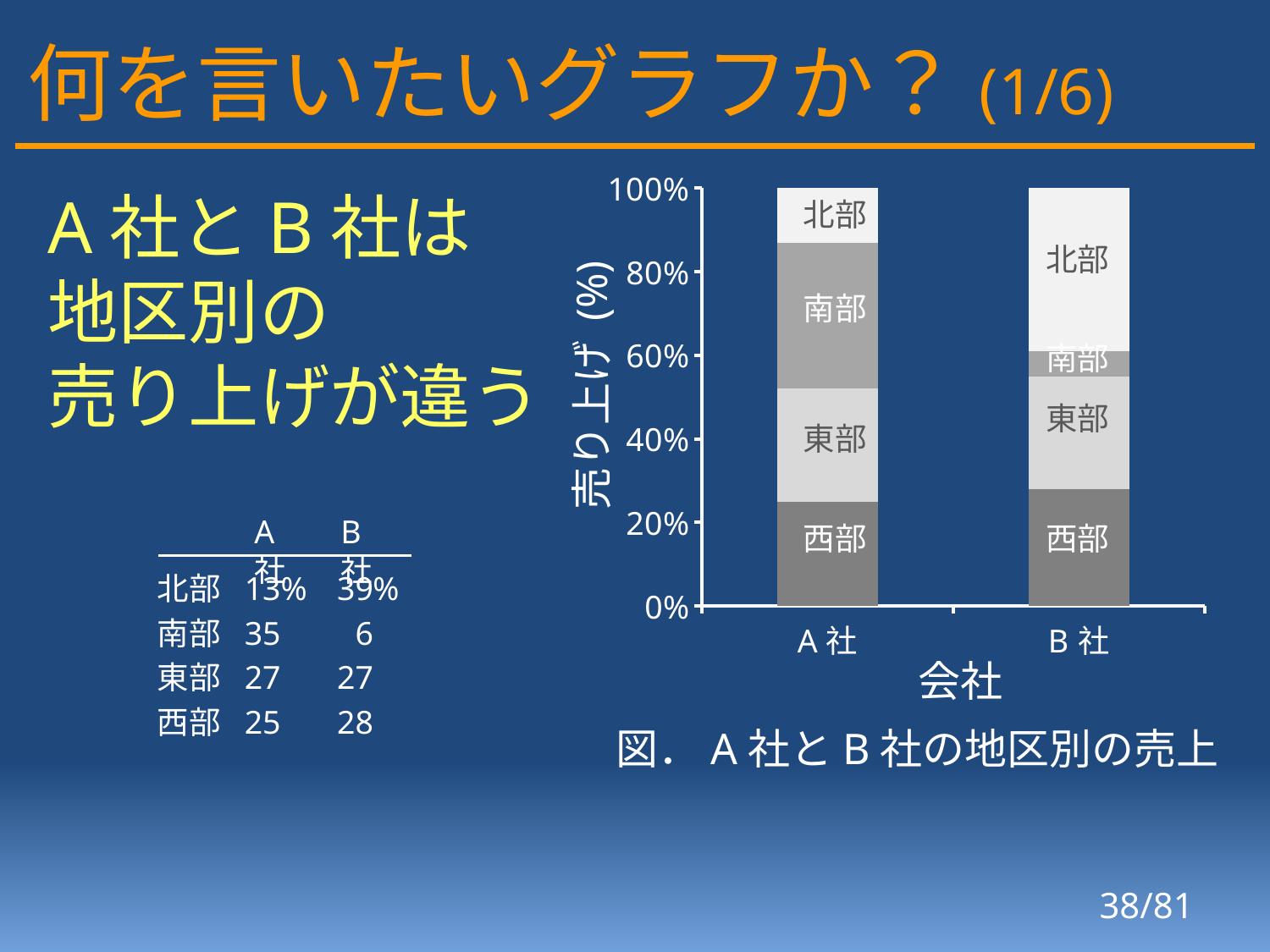
What kind of chart is shown on the slide? stacked bar chart How many companies (bars) are plotted in the chart? 2 According to the slide, what is the 北部 share of sales for B社? 39% What is the difference between the 北部 share of B社 and that of A社? 26% Which region has the smallest share of sales for B社? 南部 According to the slide, what is the 北部 share of sales for A社? 13% Which region has the largest share of sales for B社? 北部 How many region segments make up each bar in the chart? 4 What is the title of the x axis of the chart? 会社 According to the table on the slide, what is the 南部 value for B社? 6 Which company has the larger 北部 share, A社 or B社? B社 Which company has the larger 南部 share, A社 or B社? A社